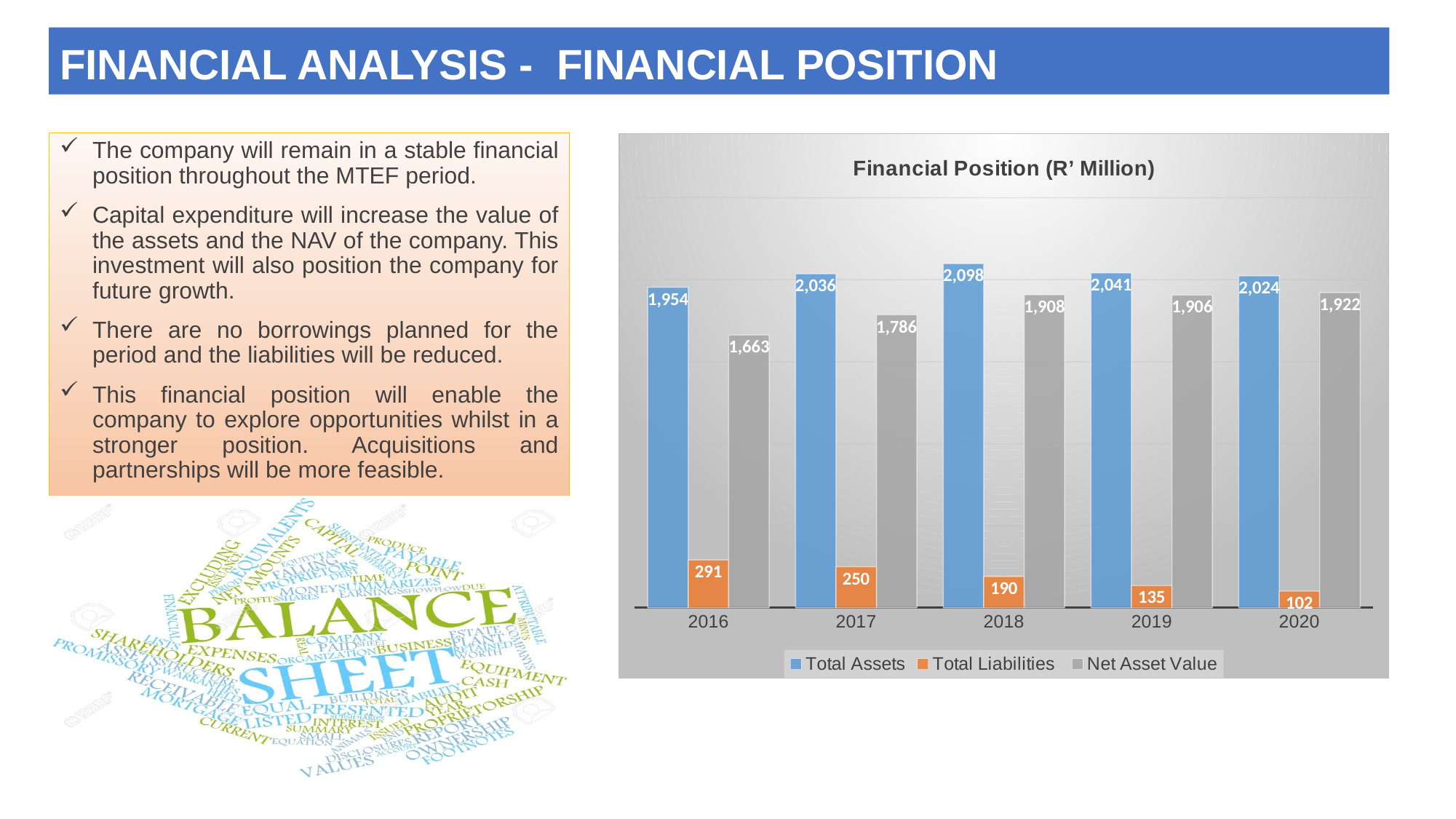
What is the Total Liabilities value for 2020? 102 In which year is Total Liabilities lowest? 2020 Which is larger, Net Asset Value in 2018 or Net Asset Value in 2020? 2020 What is the title of the chart? Financial Position (R' Million) How many series does the legend list? 3 What is the difference between Total Liabilities in 2016 and 2020? 189 How many years are shown on the x axis? 5 In which year is Total Assets highest? 2018 What is the Net Asset Value for 2016? 1,663 What is the Total Assets value for 2018? 2,098 What kind of chart is shown? Bar chart Do the Total Liabilities values rise or fall from 2016 to 2020? Fall